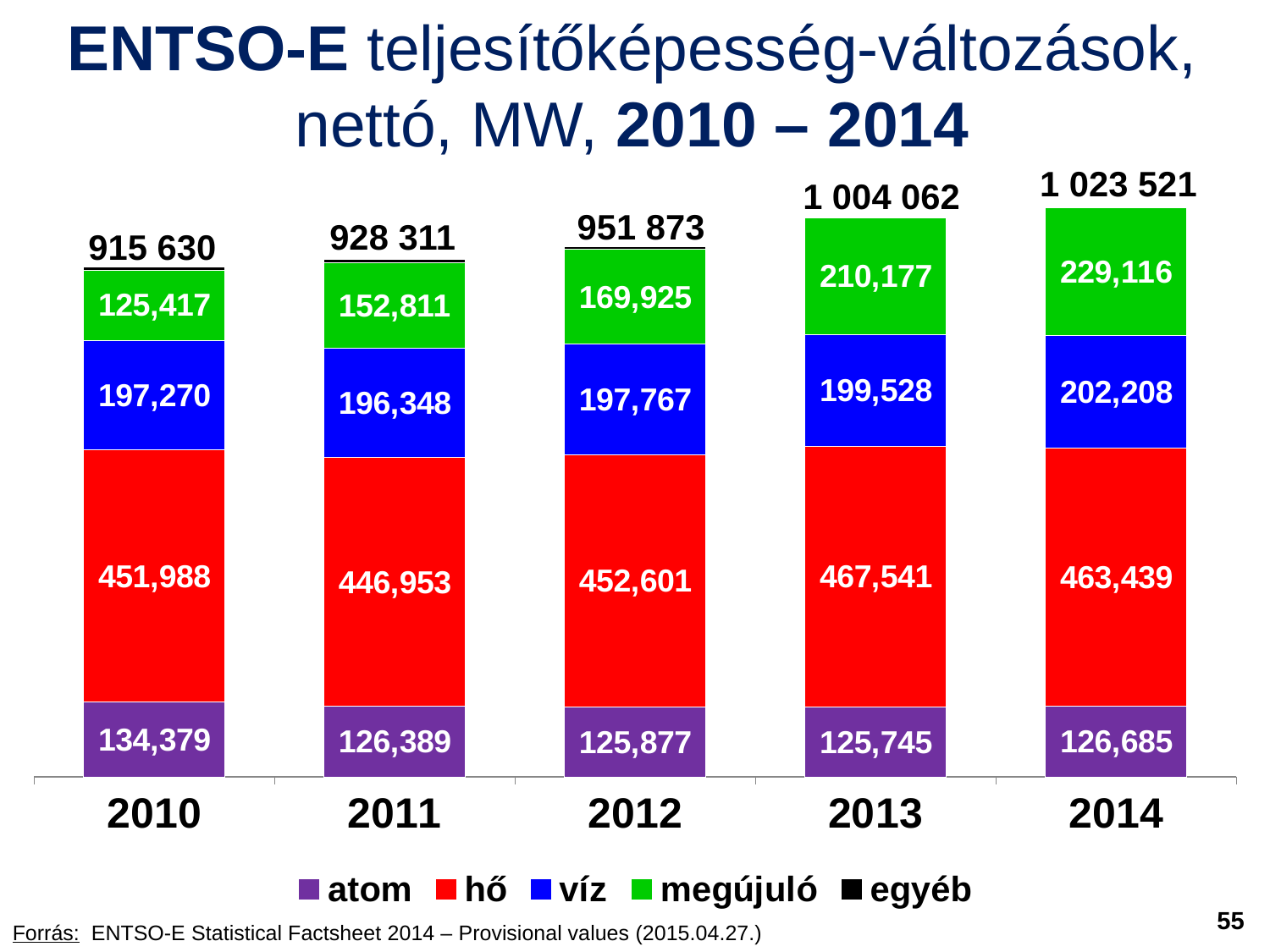
Do the totals printed above the bars rise or fall from 2010 to 2014? rise By how much did the megújuló value increase from 2010 to 2014? 103,699 What is the value of the hő segment for 2013? 467,541 How many series does the legend list? 5 Which is larger, the víz value for 2010 or for 2011? 2010 How many years are shown on the x axis? 5 What is the total printed above the 2014 bar? 1 023 521 What is the value of the megújuló segment for 2012? 169,925 What is the value of the atom segment for 2010? 134,379 What is the value of the víz segment for 2014? 202,208 In which year is the atom segment the smallest? 2013 In which year is the megújuló segment the largest? 2014